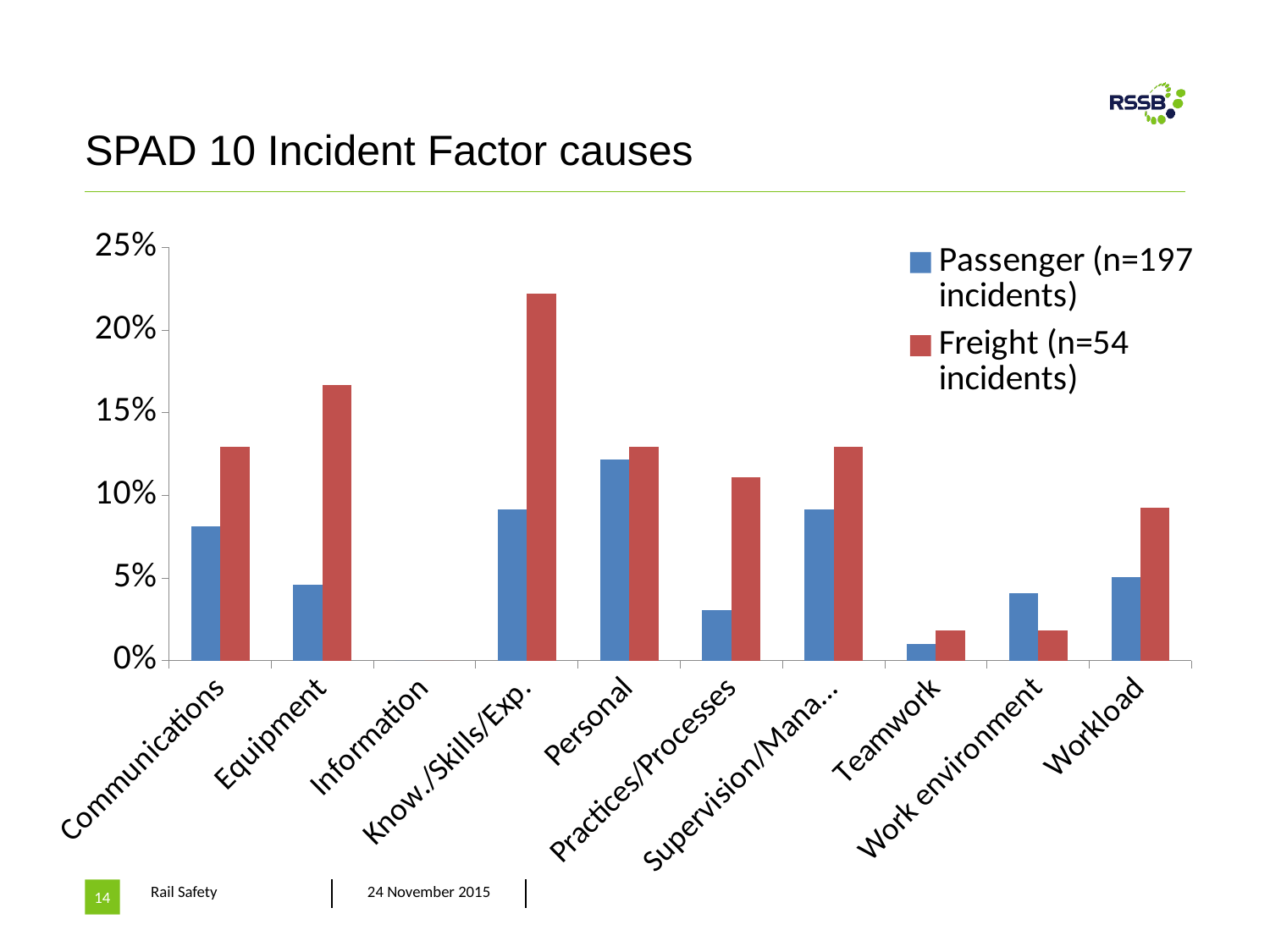
What kind of chart is shown on the slide? bar chart Which category shows no visible bar for either series? Information How many series does the legend list? 2 Is the Passenger (n=197 incidents) value for Personal greater or less than 10%? greater For Work environment, which series has the larger value, Passenger (n=197 incidents) or Freight (n=54 incidents)? Passenger (n=197 incidents) Is the Freight (n=54 incidents) value for Equipment greater or less than 15%? greater Which category has the highest Freight (n=54 incidents) value? Know./Skills/Exp. Which category has the highest Passenger (n=197 incidents) value? Personal Is the Freight (n=54 incidents) value for Know./Skills/Exp. greater or less than 20%? greater How many categories are shown on the x axis? 10 What is the title of the chart on the slide? SPAD 10 Incident Factor causes